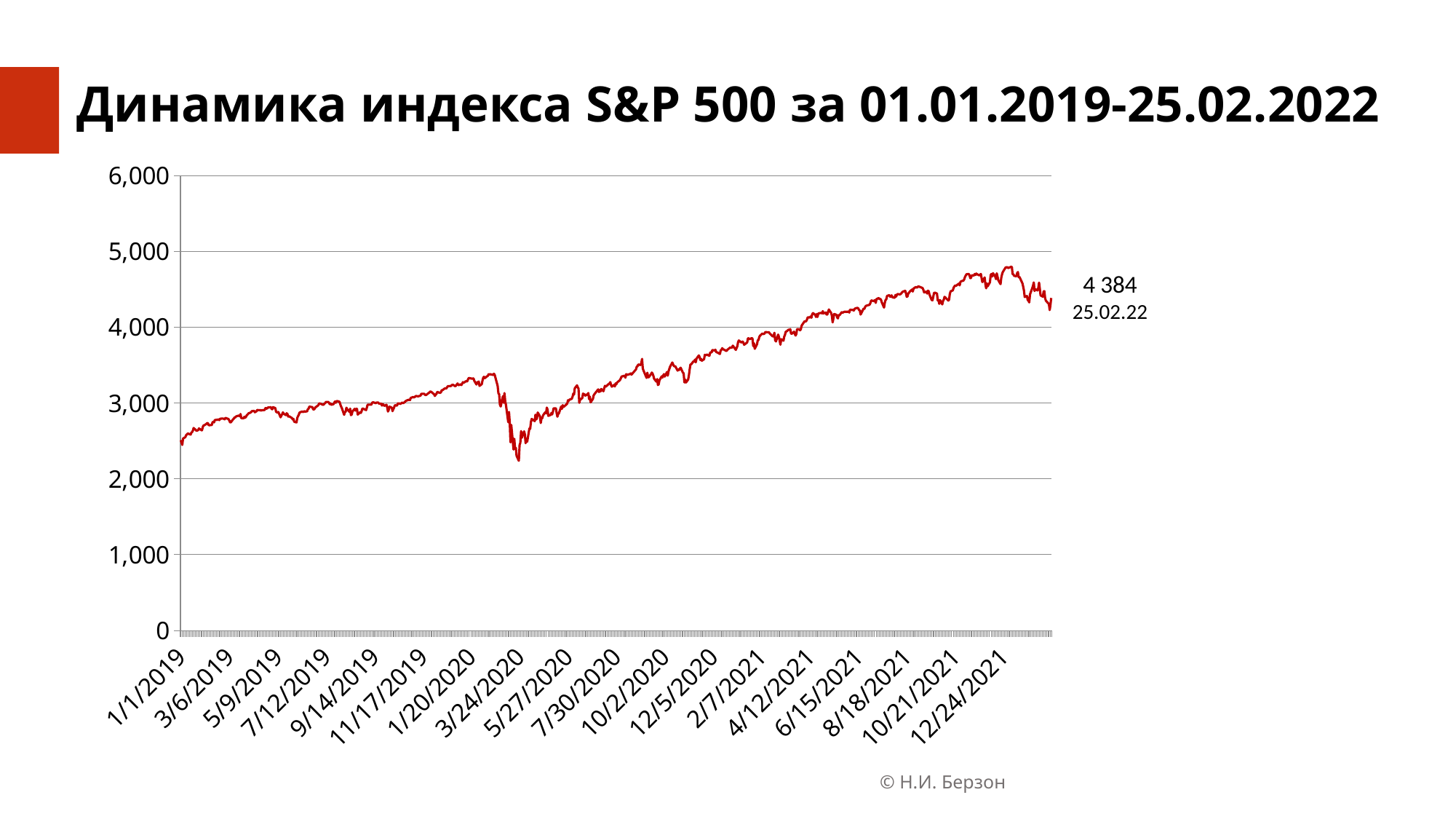
Is the value of the index at 1/1/2019 greater or less than 3,000? less How many date labels are shown on the x axis? 18 What kind of chart is shown on the slide? line chart Is the highest value reached by the line greater or less than 5,000? less What value of the S&P 500 index is labelled on the chart for 25.02.22? 4 384 Is the value of the index at 12/24/2021 greater or less than 4,000? greater What is the title of the chart on the slide? Динамика индекса S&P 500 за 01.01.2019-25.02.2022 What colour is the line plotted on the chart? red Which is larger: the index value at 12/24/2021 or at 1/1/2019? 12/24/2021 Overall, does the index rise or fall from 1/1/2019 to the end of the chart? rise